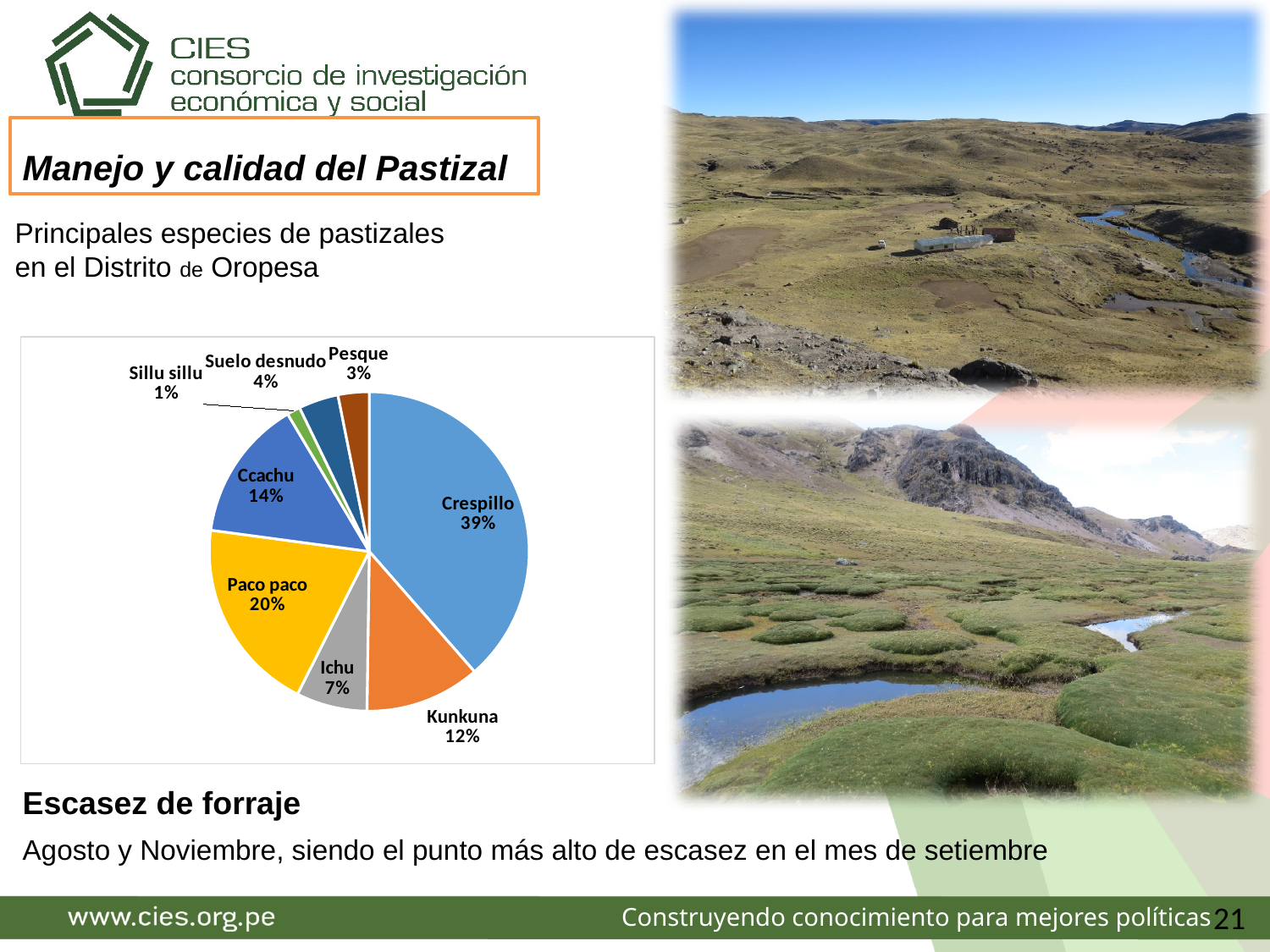
Which has a larger share, Ichu or Kunkuna? Kunkuna How many slices does the pie chart have? 8 What is the value shown for Paco paco? 20% Which category has the smallest share of the pie? Sillu sillu What is the value shown for Kunkuna? 12% What kind of chart is shown on the slide? pie chart What is the combined share of Ichu and Pesque? 10% What share of the pie does Crespillo have? 39% What is the value shown for Suelo desnudo? 4% What is the value shown for Ccachu? 14% What is the difference between the shares of Crespillo and Paco paco? 19% Which species has the largest share of the pie? Crespillo